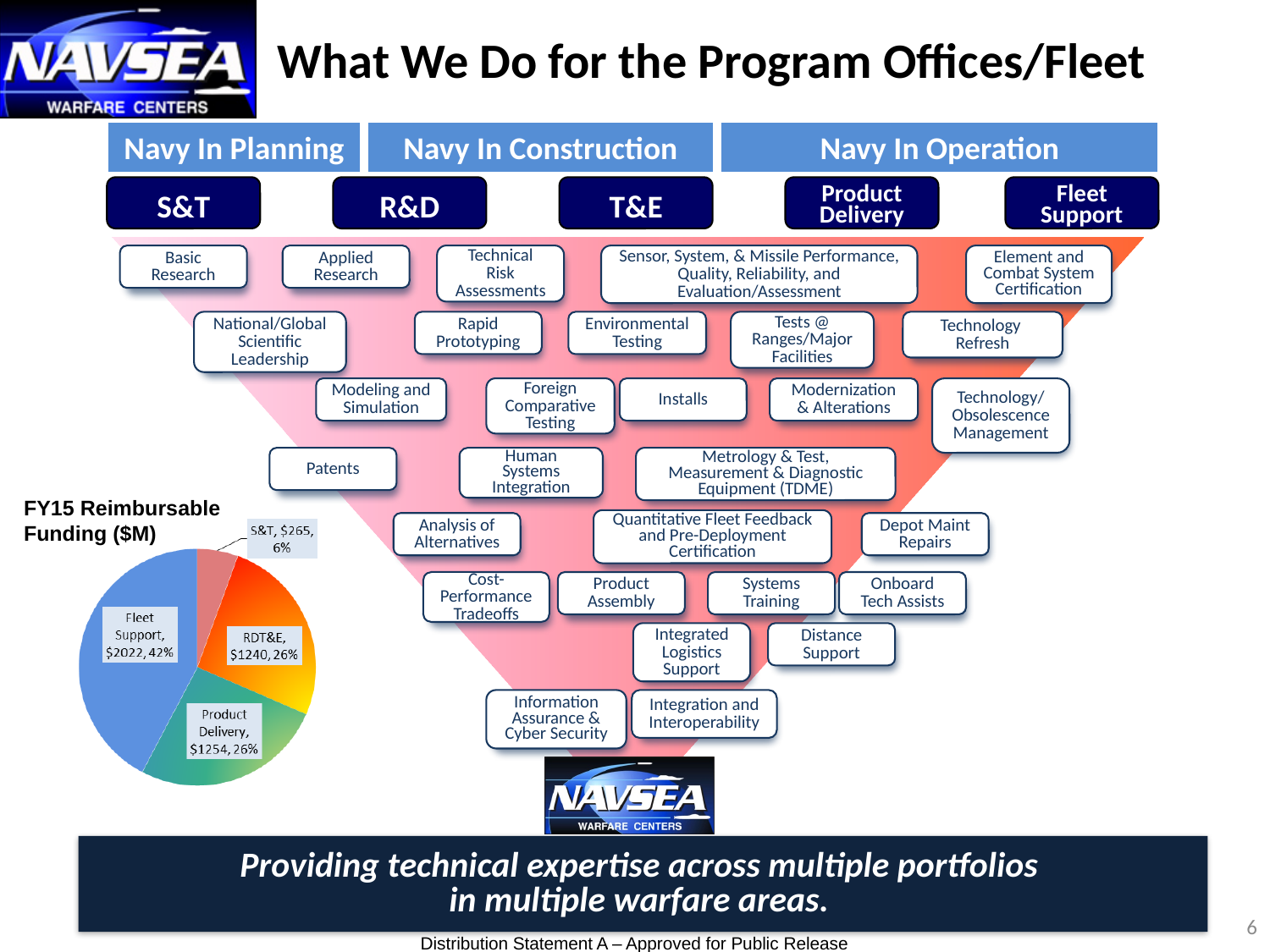
Which category has the smallest share of FY15 reimbursable funding? S&T What is the FY15 reimbursable funding value for RDT&E? $1240 What is the FY15 reimbursable funding value for Fleet Support? $2022 What is the difference in FY15 reimbursable funding between Fleet Support and S&T? $1757 How many slices does the FY15 Reimbursable Funding pie chart have? 4 What is the title of the chart on the slide? FY15 Reimbursable Funding ($M) What is the FY15 reimbursable funding value for S&T? $265 What is the FY15 reimbursable funding value for Product Delivery? $1254 What is the total FY15 reimbursable funding across all four categories in the pie chart? $4781 What kind of chart is shown on the slide? pie chart What percentage share of FY15 reimbursable funding does Fleet Support represent? 42% Which category has the largest share of FY15 reimbursable funding? Fleet Support